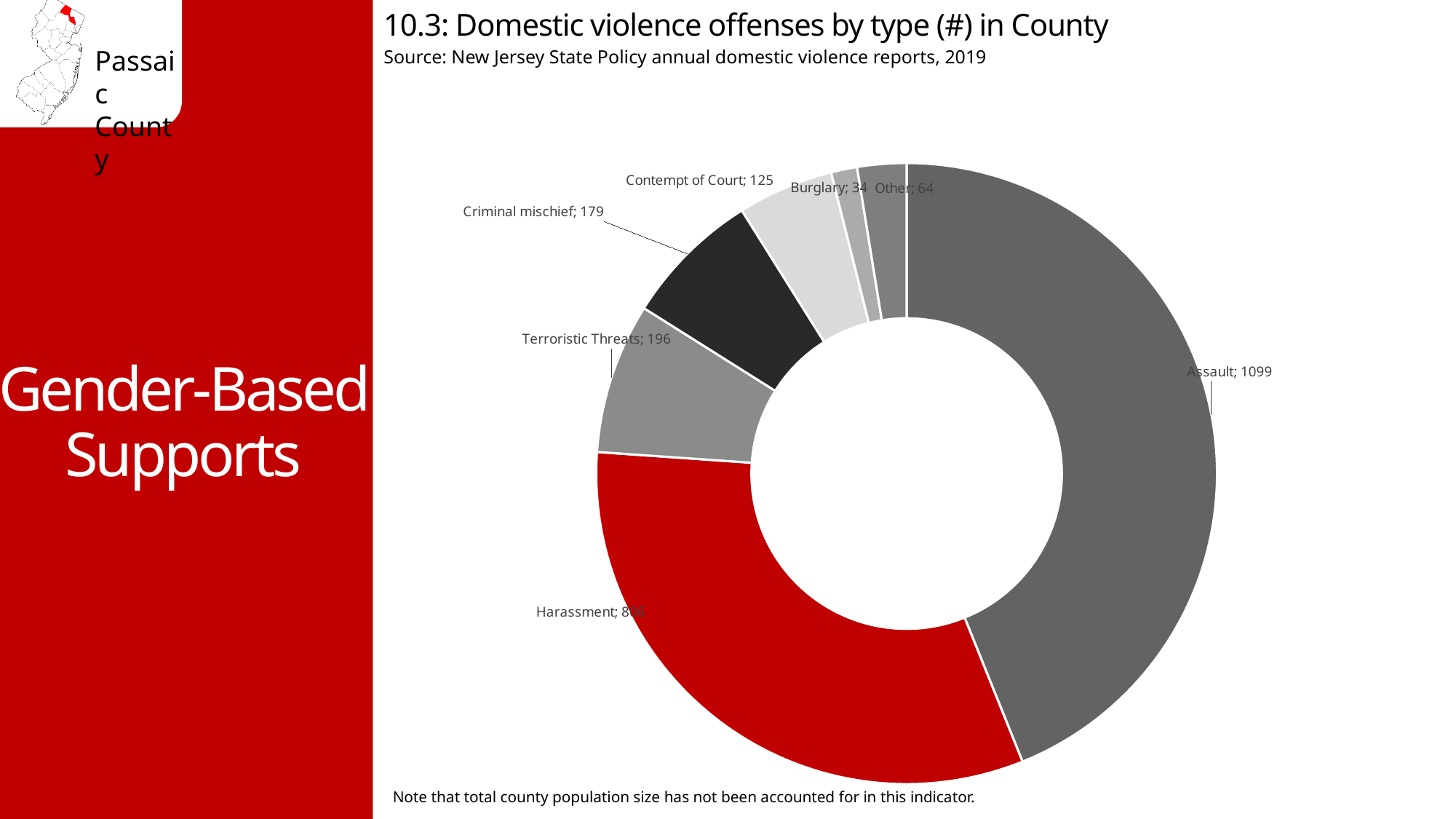
What is the difference between the values for Assault and Criminal mischief? 920 Which is larger, the value for Assault or the value for Harassment? Assault What is the value for Contempt of Court? 125 Which offense type has the highest value? Assault What is the value for Other? 64 What is the value for Assault? 1099 What kind of chart is shown on the slide? Doughnut (pie) chart How many offense types are shown in the chart? 7 What is the value for Terroristic Threats? 196 Which offense type has the lowest value? Burglary What is the value for Burglary? 34 What is the value for Criminal mischief? 179